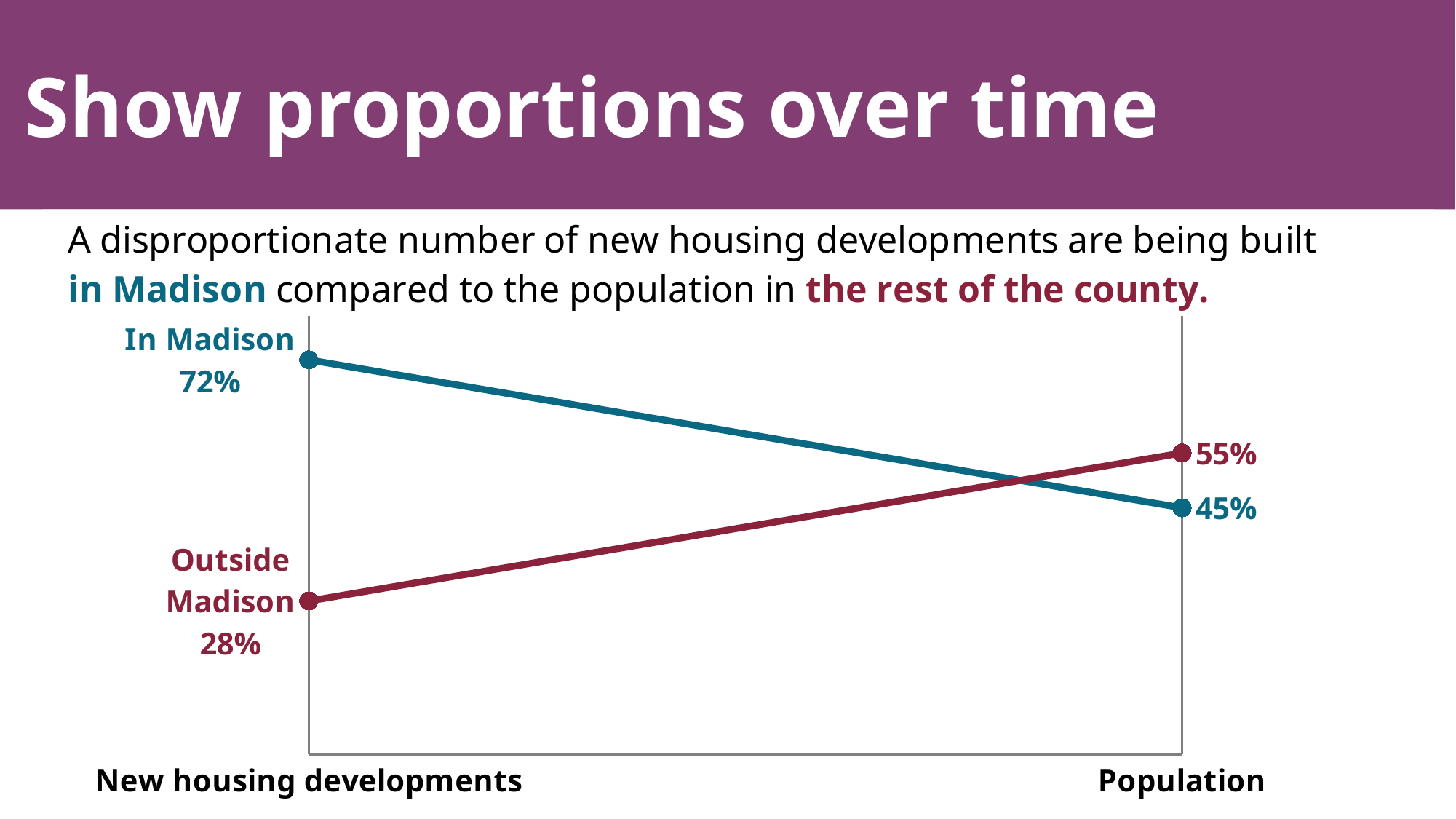
Which series has the lower value for Population? In Madison What is the value for In Madison under Population? 45% Does the In Madison line rise or fall from New housing developments to Population? Fall Which series has the higher value for New housing developments? In Madison How many series are plotted on the chart? 2 Is the Outside Madison value larger for New housing developments or for Population? Population What is the value for Outside Madison under Population? 55% What is the difference between the In Madison and Outside Madison values for New housing developments? 44% What is the value for Outside Madison under New housing developments? 28% What is the value for In Madison under New housing developments? 72% What kind of chart is shown on the slide? Line chart What is the difference between the In Madison values for New housing developments and Population? 27%